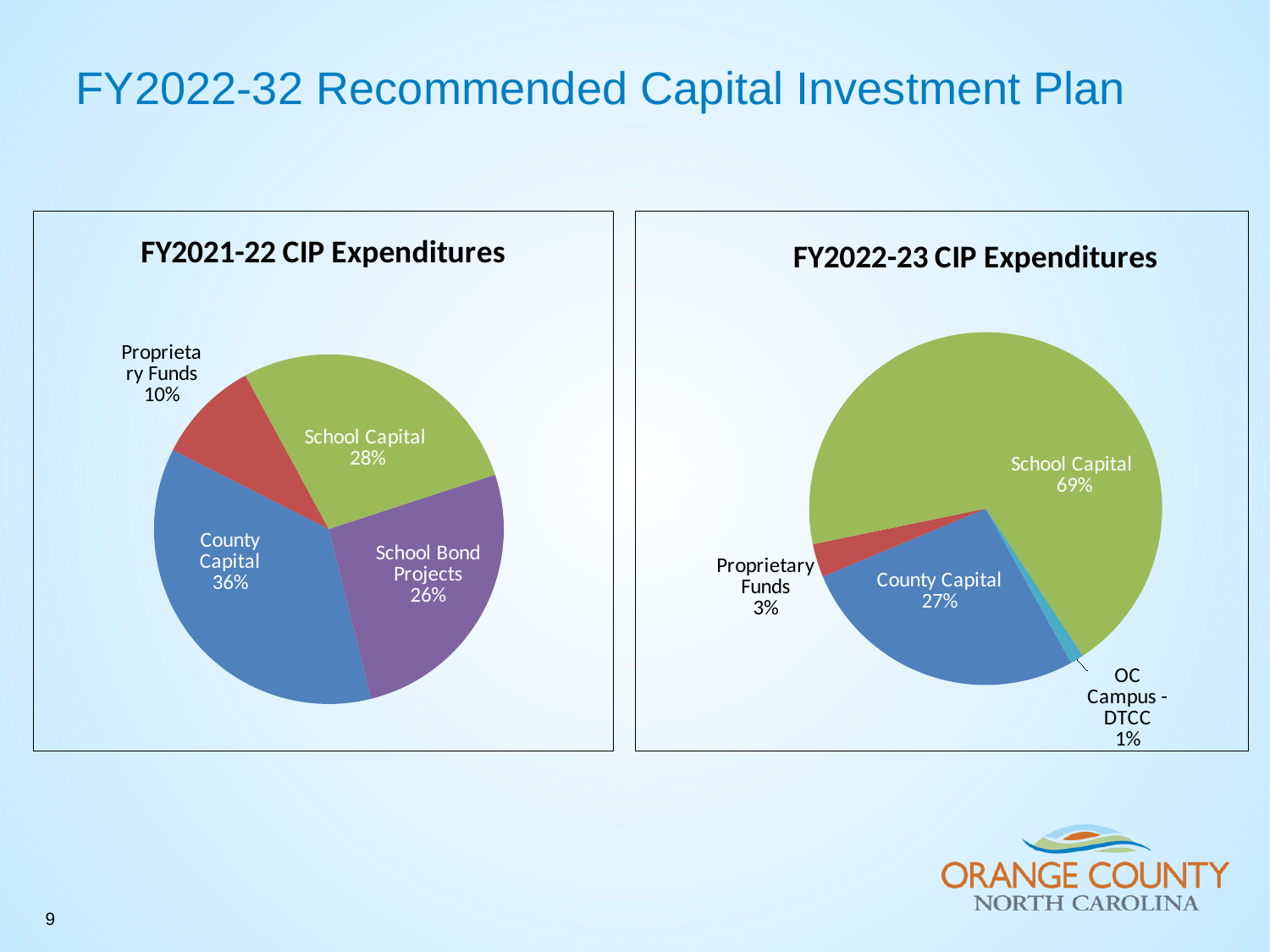
How many categories are shown in the FY2022-23 CIP Expenditures chart? 4 In the FY2022-23 CIP Expenditures chart, what share does School Capital have? 69% What kind of chart is the FY2021-22 CIP Expenditures chart? Pie chart In the FY2021-22 CIP Expenditures chart, what share does County Capital have? 36% In the FY2021-22 CIP Expenditures chart, which is larger: School Capital or School Bond Projects? School Capital In the FY2021-22 CIP Expenditures chart, what colour is the School Capital slice? Green In the FY2021-22 CIP Expenditures chart, which category has the smallest share? Proprietary Funds In the FY2022-23 CIP Expenditures chart, what share does OC Campus - DTCC have? 1% In the FY2022-23 CIP Expenditures chart, what is the difference between the School Capital and County Capital shares? 42% In the FY2021-22 CIP Expenditures chart, which category has the largest share? County Capital In the FY2021-22 CIP Expenditures chart, what share does School Bond Projects have? 26% In the FY2022-23 CIP Expenditures chart, which category has the smallest share? OC Campus - DTCC